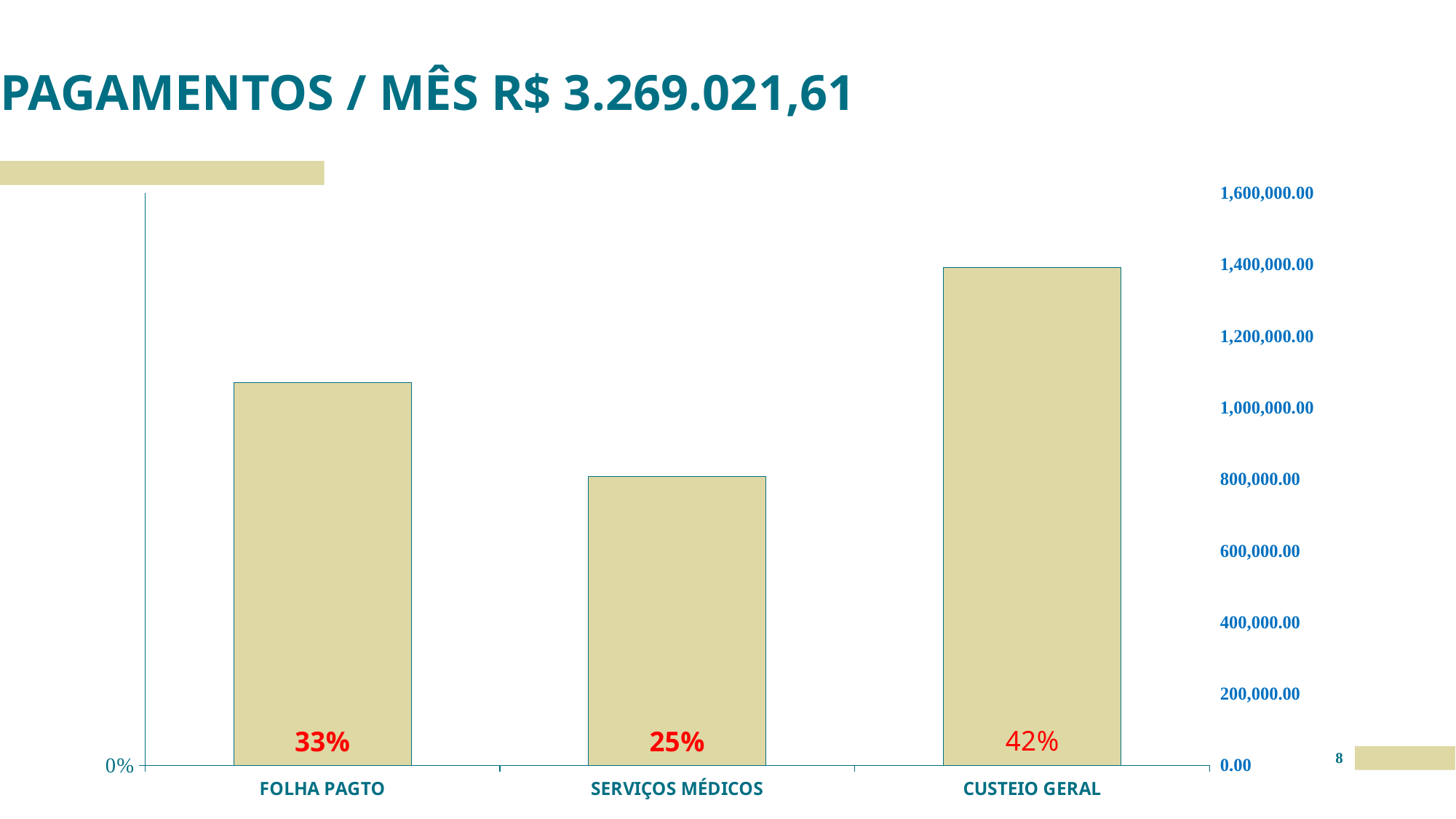
What percentage label is shown on the FOLHA PAGTO bar? 33% What type of chart is shown on the slide? Bar chart Which category has the lowest bar? SERVIÇOS MÉDICOS Is the value for SERVIÇOS MÉDICOS on the right-hand axis greater or less than 1,000,000.00? less Which is larger, the bar for FOLHA PAGTO or the bar for SERVIÇOS MÉDICOS? FOLHA PAGTO What percentage label is shown on the SERVIÇOS MÉDICOS bar? 25% Is the value for FOLHA PAGTO on the right-hand axis greater or less than 1,000,000.00? greater What is the difference in percentage points between the CUSTEIO GERAL label and the SERVIÇOS MÉDICOS label? 17% How many categories are shown on the x axis? 3 Is the value for CUSTEIO GERAL on the right-hand axis greater or less than 1,200,000.00? greater What percentage label is shown on the CUSTEIO GERAL bar? 42% Which category has the highest bar? CUSTEIO GERAL